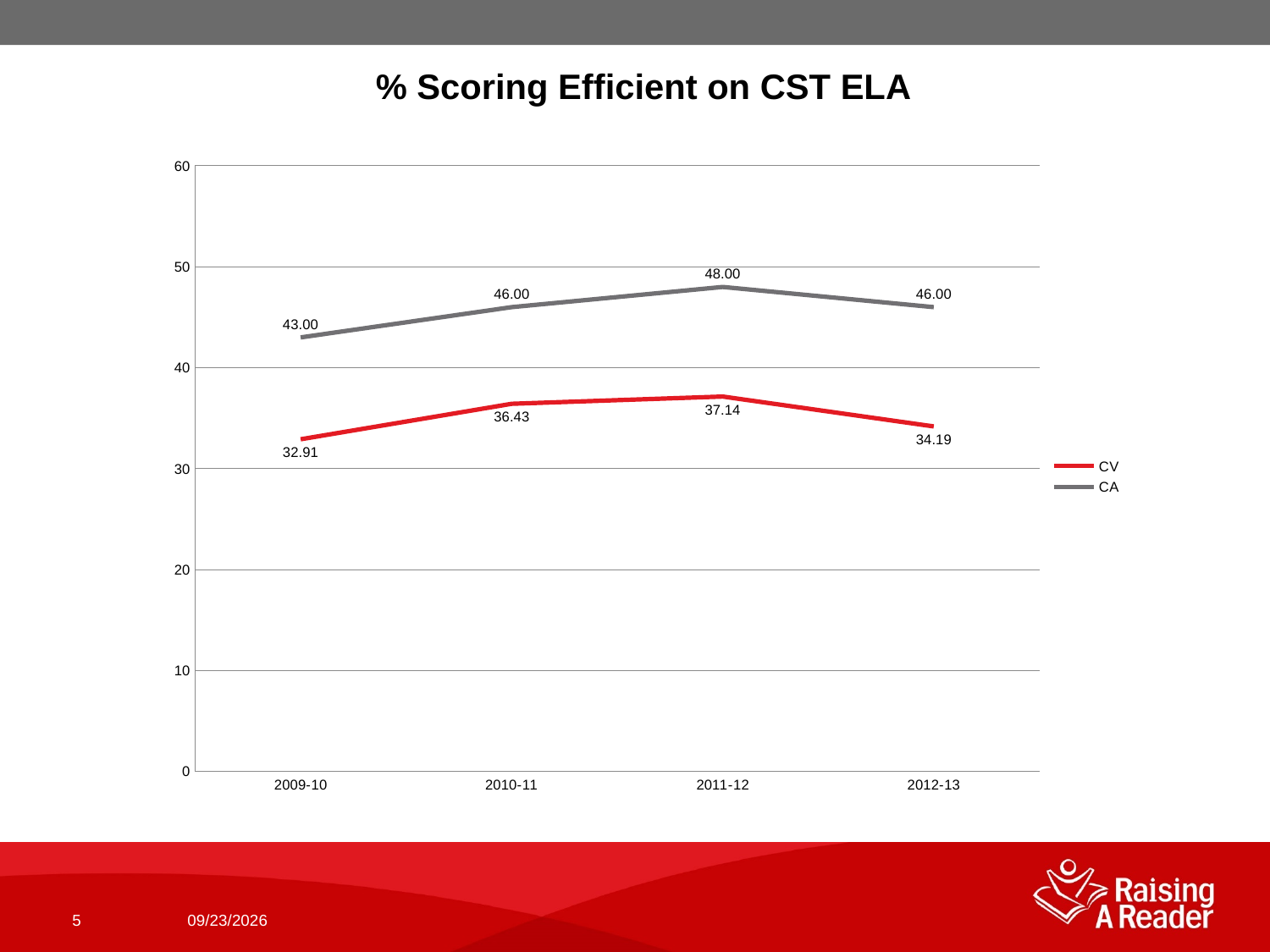
How many years are shown on the x axis? 4 Which is larger in 2012-13, the CV value or the CA value? CA What is the CV value for 2012-13? 34.19 In which year is the CA value highest? 2011-12 How many series does the legend list? 2 What is the CV value for 2009-10? 32.91 What is the CA value for 2011-12? 48.00 In which year is the CV value lowest? 2009-10 What kind of chart is shown on the slide? line chart What is the difference between the CA and CV values in 2010-11? 9.57 Is the CV value for 2011-12 greater or less than 40? less Does the CA value rise or fall from 2011-12 to 2012-13? fall